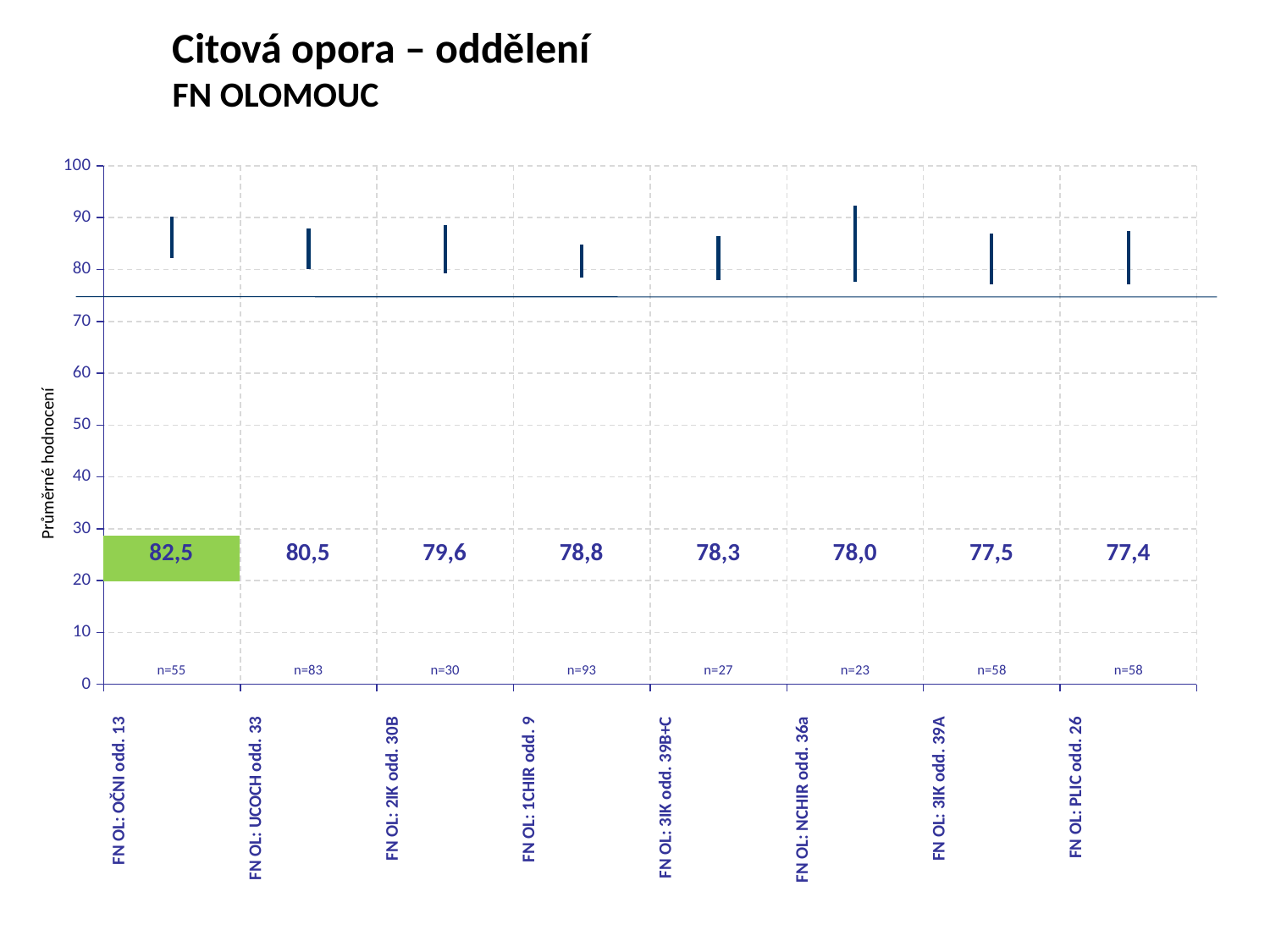
Which department has the highest average rating? FN OL: OČNI odd. 13 Which department has the lowest average rating? FN OL: PLIC odd. 26 Which has a higher average rating, FN OL: 2IK odd. 30B or FN OL: 3IK odd. 39A? FN OL: 2IK odd. 30B Do the average ratings rise or fall from left to right along the x axis? fall What is the difference between the average ratings of FN OL: OČNI odd. 13 and FN OL: UCOCH odd. 33? 2,0 What is the title of the chart? Citová opora – oddělení, FN OLOMOUC How many departments are shown in the chart? 8 What is the average rating for FN OL: PLIC odd. 26? 77,4 What is the average rating (průměrné hodnocení) for FN OL: OČNI odd. 13? 82,5 What is the average rating for FN OL: NCHIR odd. 36a? 78,0 What is the sample size (n) for FN OL: 1CHIR odd. 9? n=93 Which department's value label is highlighted with a green background? FN OL: OČNI odd. 13